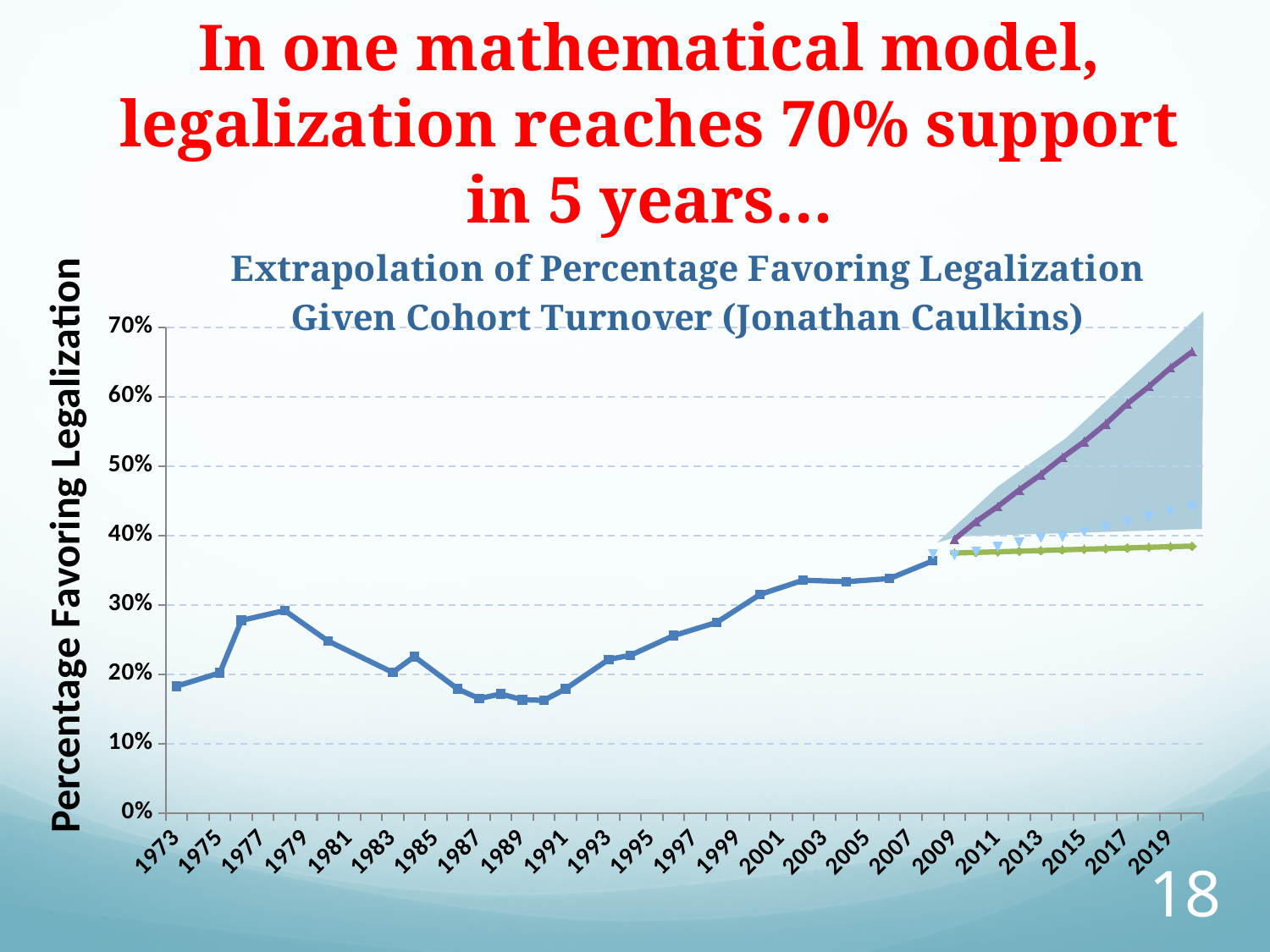
Is the value for 2003 greater or less than 30%? greater What kind of chart is shown on the slide? line chart Is the value of the upper (purple) extrapolation line in 2019 greater or less than 60%? greater Which year has the larger value, 1977 or 1973? 1977 Is the value for 1979 greater or less than 30%? less What is the label on the vertical axis of the chart? Percentage Favoring Legalization What is the title of the chart? Extrapolation of Percentage Favoring Legalization Given Cohort Turnover (Jonathan Caulkins) Which year has the larger value, 2001 or 1995? 2001 Does the historical line generally rise or fall between 1991 and 2007? rise